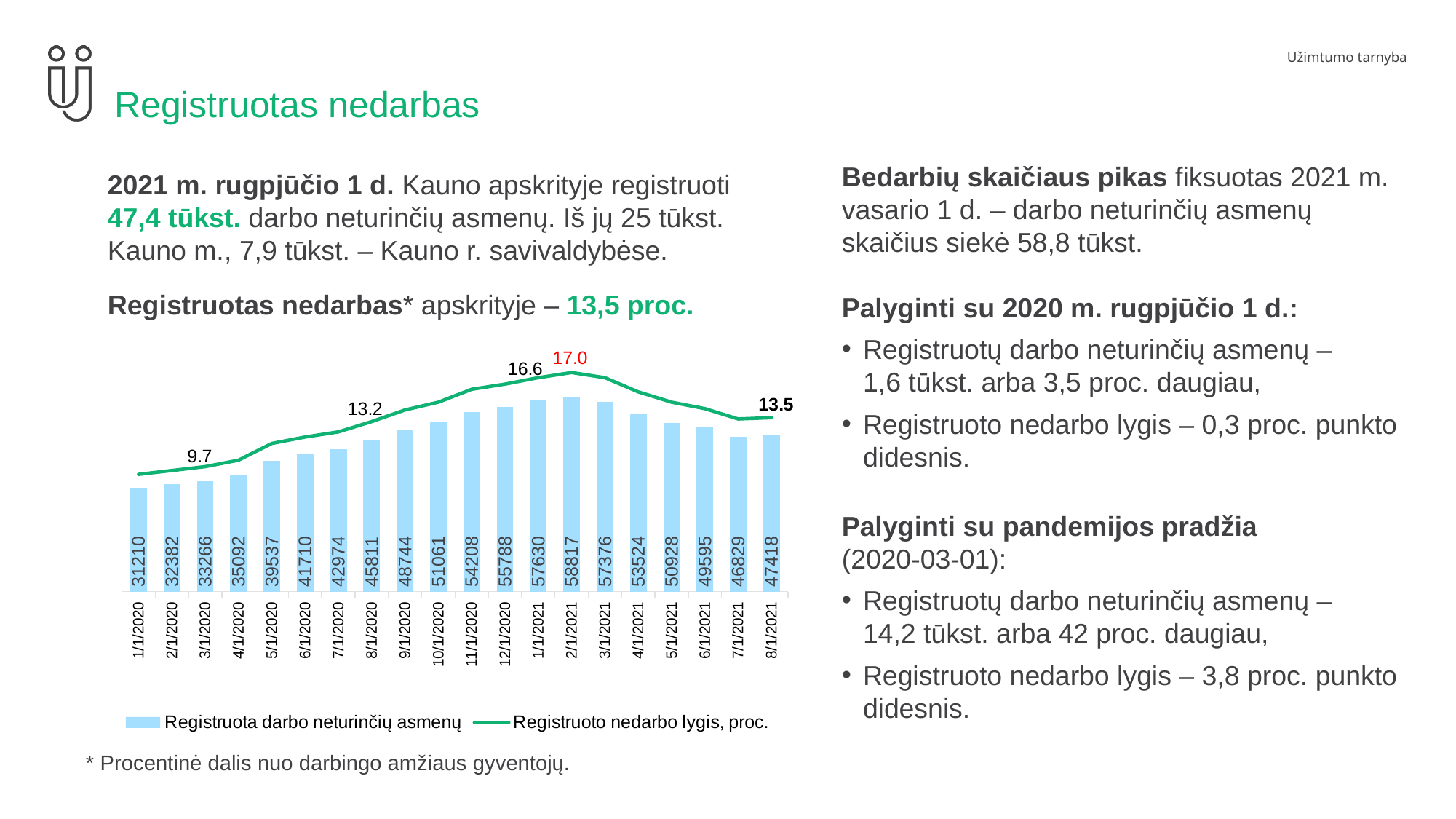
What is the difference between the bar values for 8/1/2021 and 8/1/2020? 1607 How many dates (bars) are shown on the x axis? 20 Which date has the highest bar (most registered unemployed persons)? 2/1/2021 What value does the line series show at 2/1/2021? 17.0 What is the difference between the bar values for 2/1/2021 and 3/1/2021? 1441 What kind of chart is shown on the slide? Combination bar and line chart How many series does the legend list? 2 What is the value of the bar for 8/1/2021? 47418 Do the bar values rise or fall from 1/1/2020 to 2/1/2021? Rise Which bar is larger, 7/1/2021 or 8/1/2021? 8/1/2021 Which date has the lowest bar? 1/1/2020 What is the value of the bar for 1/1/2020? 31210